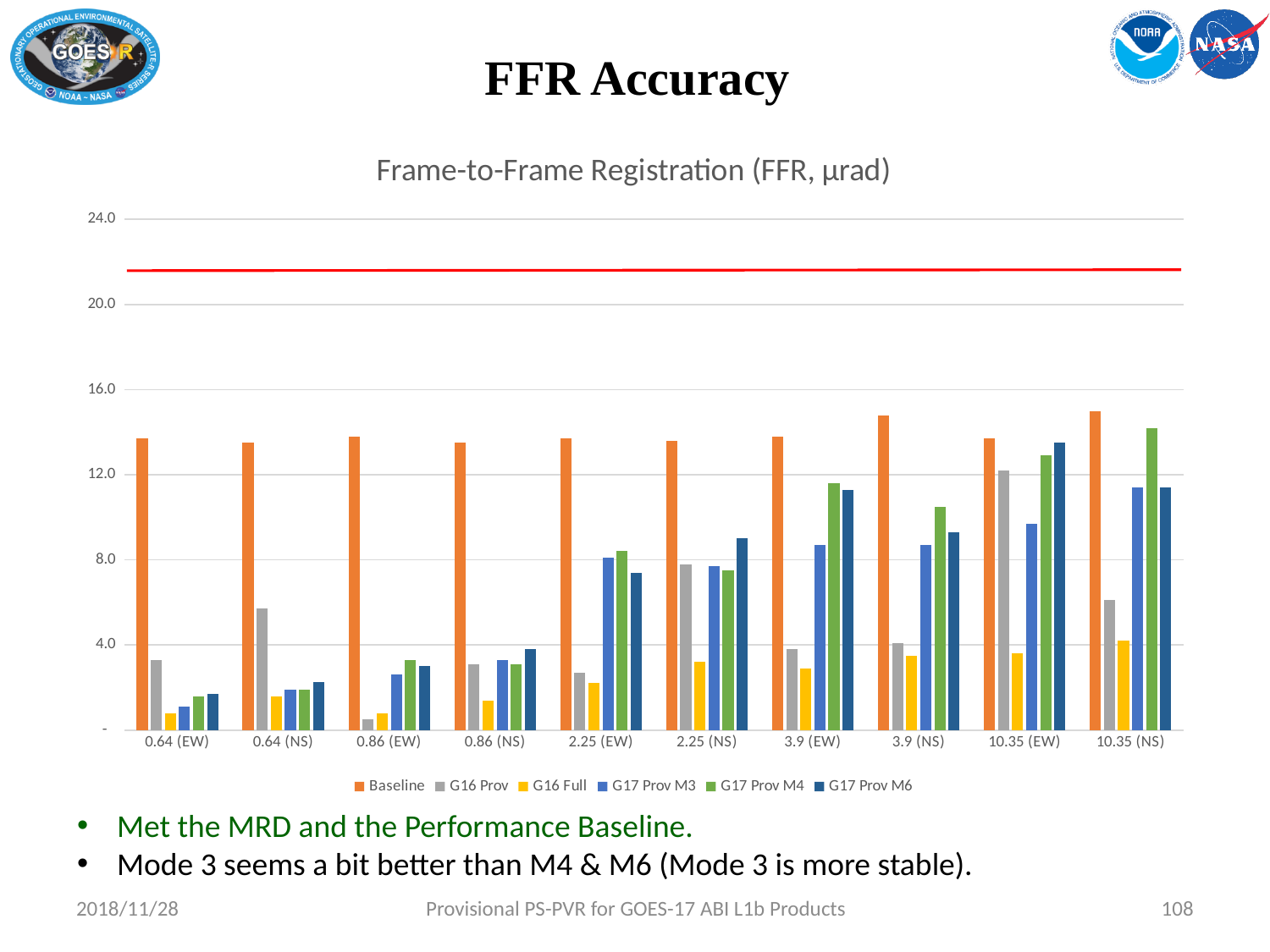
Is the Baseline value for 0.64 (EW) greater or less than 12.0? greater What is the title of the chart? Frame-to-Frame Registration (FFR, μrad) Which series has the highest value for 0.64 (EW)? Baseline How many series does the chart legend list? 6 How many categories are shown along the x axis? 10 Is the G17 Prov M4 value for 10.35 (NS) greater or less than 12.0? greater Is the G16 Prov value for 0.64 (NS) greater or less than 4.0? greater For 3.9 (NS), which is larger: G17 Prov M3 or G17 Prov M4? G17 Prov M4 What kind of chart is shown on the slide? Bar chart Which series is shown in orange in the legend? Baseline Which series has the lowest value for 10.35 (EW)? G16 Full